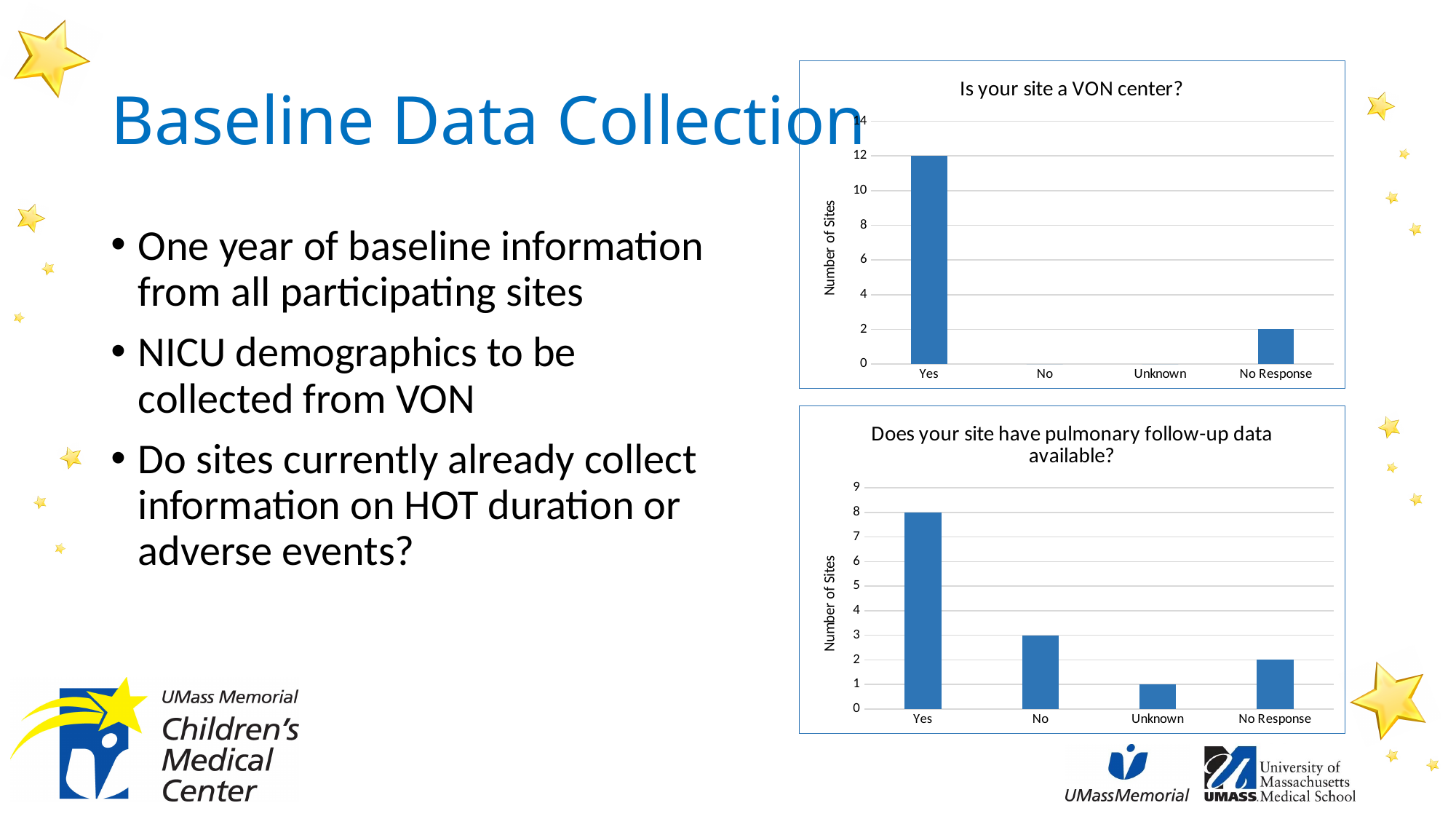
In the chart titled "Does your site have pulmonary follow-up data available?", what is the difference between the number of sites for Yes and for No? 5 In the chart titled "Does your site have pulmonary follow-up data available?", which category has the lowest number of sites? Unknown In the chart titled "Is your site a VON center?", what is the number of sites for Yes? 12 In the chart titled "Does your site have pulmonary follow-up data available?", which is larger, the value for No or the value for No Response? No In the chart titled "Is your site a VON center?", what is the difference between the number of sites for Yes and for No Response? 10 In the chart titled "Is your site a VON center?", what is the number of sites for No Response? 2 In the chart titled "Is your site a VON center?", which category has the highest number of sites? Yes What is the y-axis label of the top chart on the slide? Number of Sites What kind of chart is the bottom chart on the slide? Bar chart In the chart titled "Does your site have pulmonary follow-up data available?", what is the number of sites for Yes? 8 In the chart titled "Does your site have pulmonary follow-up data available?", what is the number of sites for No? 3 In the chart titled "Is your site a VON center?", how many categories are shown on the x axis? 4